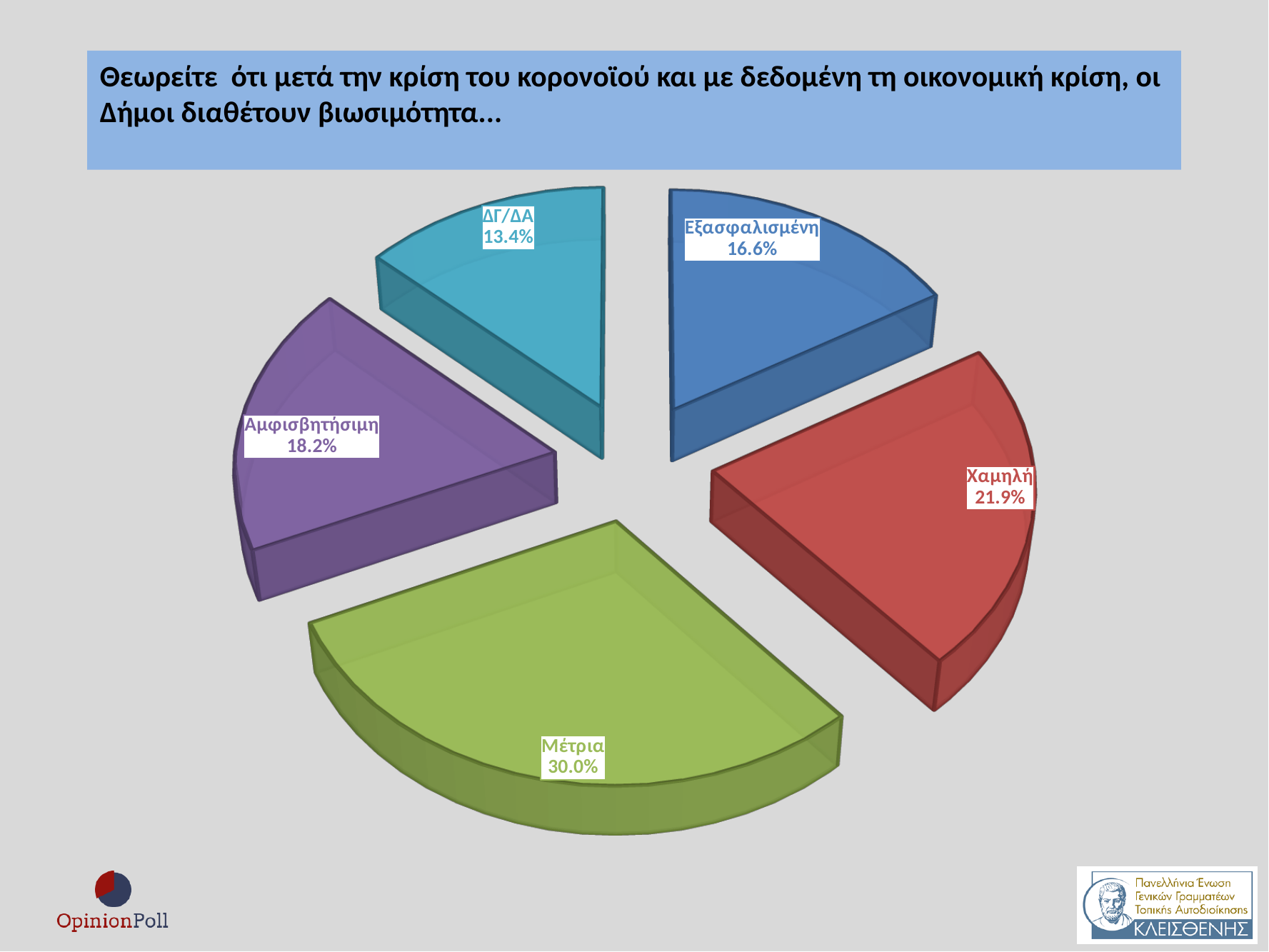
Which is larger, the share for Αμφισβητήσιμη or the share for Εξασφαλισμένη? Αμφισβητήσιμη How many slices does the pie chart have? 5 Which response has the smallest share of the pie? ΔΓ/ΔΑ What percentage of respondents answered Εξασφαλισμένη? 16.6% What percentage of respondents answered Μέτρια? 30.0% What colour is the slice for Χαμηλή? Red What percentage of respondents answered ΔΓ/ΔΑ? 13.4% What percentage of respondents answered Χαμηλή? 21.9% What type of chart is shown on the slide? Pie chart What percentage of respondents answered Αμφισβητήσιμη? 18.2% Which response has the largest share of the pie? Μέτρια What is the difference in percentage points between Μέτρια and Χαμηλή? 8.1